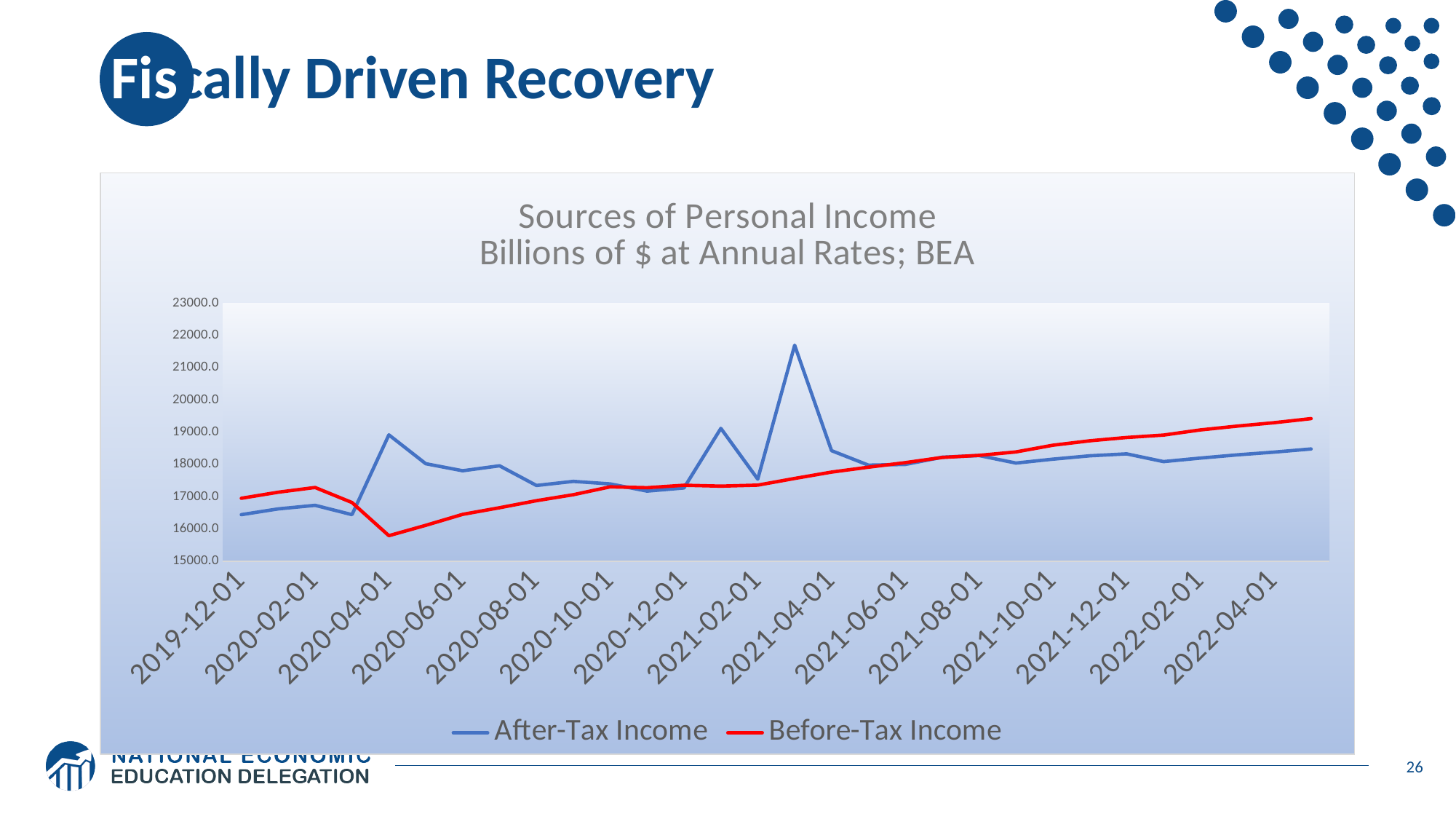
Which colour is used for the Before-Tax Income line? Red Does Before-Tax Income rise or fall from 2020-04-01 to 2022-04-01? Rises Is the lowest value of Before-Tax Income greater or less than 16000.0? less What is the title of the chart? Sources of Personal Income Billions of $ at Annual Rates; BEA How many series does the legend list? 2 What type of chart is shown on the slide? Line chart Is the value of After-Tax Income at 2019-12-01 greater or less than 17000.0? less Is the value of Before-Tax Income at 2022-04-01 greater or less than 19000.0? greater How many date labels are shown on the x axis? 15 At 2022-04-01, which series has the higher value, After-Tax Income or Before-Tax Income? Before-Tax Income At 2020-04-01, which series has the higher value, After-Tax Income or Before-Tax Income? After-Tax Income